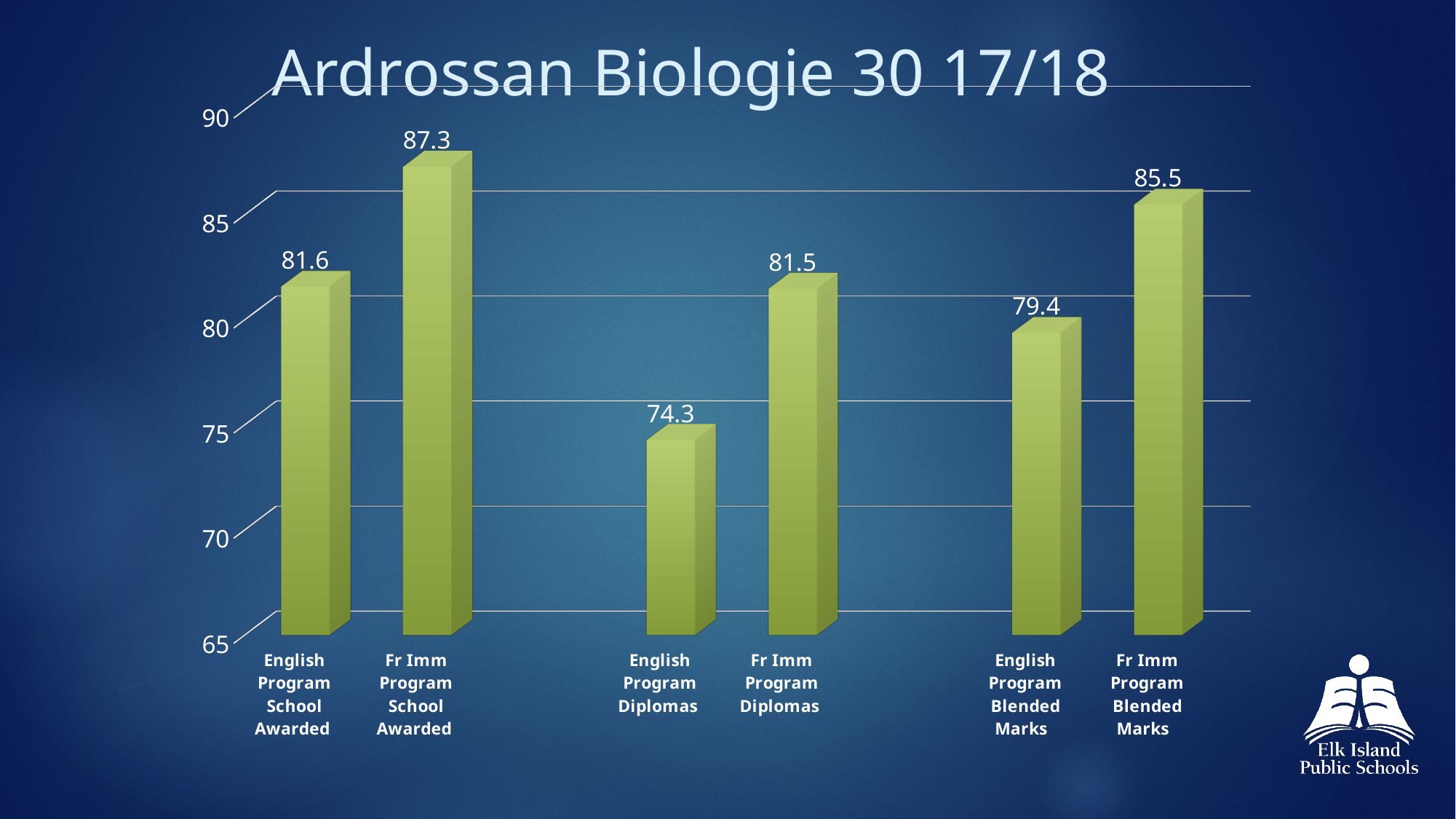
Which category has the highest value? Fr Imm Program School Awarded What is the value for English Program Diplomas? 74.3 What is the title of the chart? Ardrossan Biologie 30 17/18 What kind of chart is shown on the slide? bar chart Which is larger, Fr Imm Program School Awarded or English Program School Awarded? Fr Imm Program School Awarded Is the value for English Program Blended Marks greater or less than 80? less What is the value for Fr Imm Program School Awarded? 87.3 How many bars are shown in the chart? 6 Which category has the lowest value? English Program Diplomas What is the difference between Fr Imm Program Blended Marks and English Program Blended Marks? 6.1 What is the value for English Program Blended Marks? 79.4 What is the difference between Fr Imm Program Diplomas and English Program Diplomas? 7.2